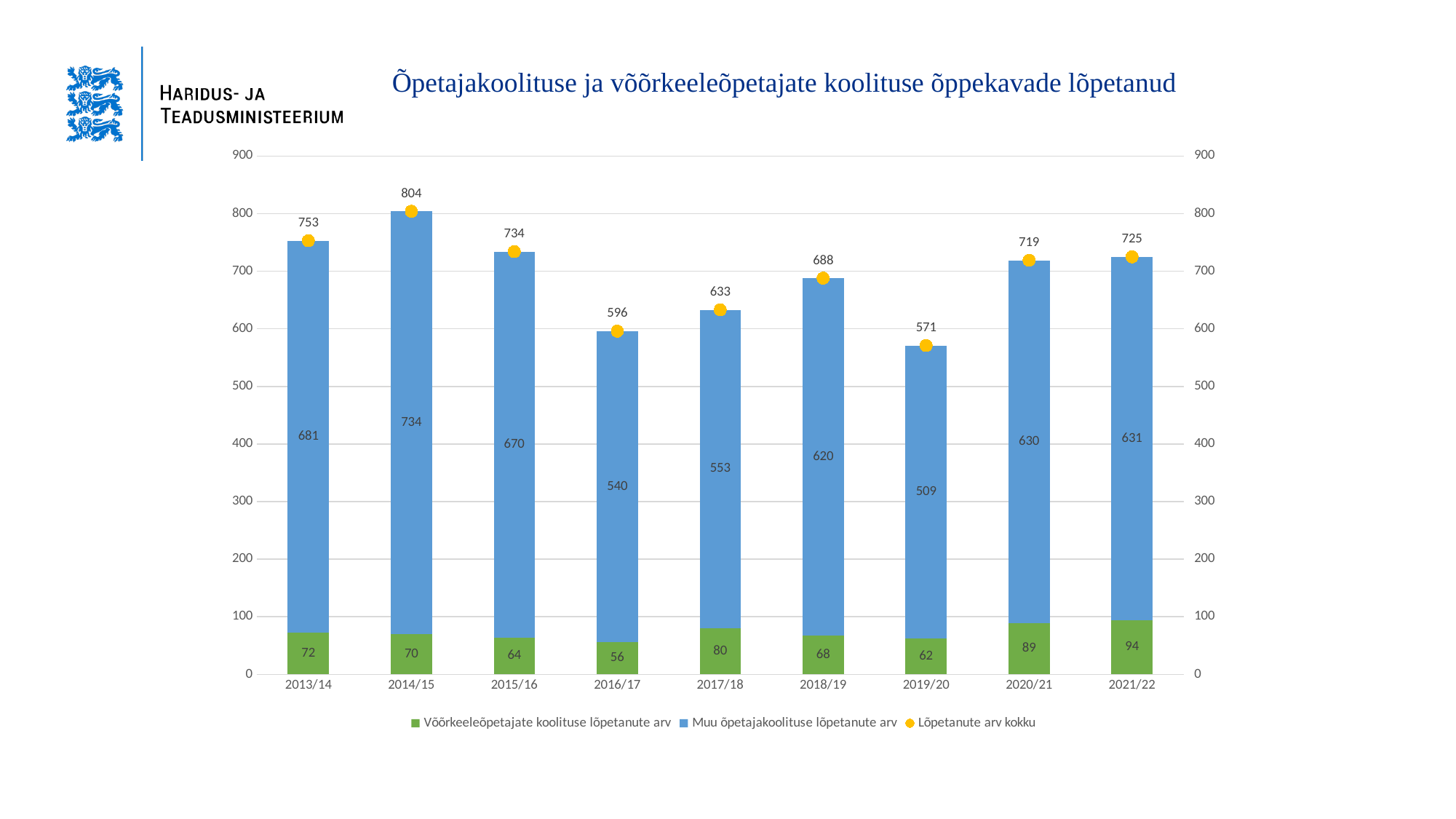
Is the total for 2019/20 greater or less than 600? less What is the Lõpetanute arv kokku value for 2018/19? 688 Which year has the lowest Võõrkeeleõpetajate koolituse lõpetanute arv? 2016/17 What is the total of the stacked bar for 2020/21? 719 What kind of chart is shown on the slide? Stacked bar chart with total markers Which year has the highest Lõpetanute arv kokku? 2014/15 How many academic years are shown on the x axis? 9 What is the value of Võõrkeeleõpetajate koolituse lõpetanute arv for 2021/22? 94 What is the value of Muu õpetajakoolituse lõpetanute arv for 2016/17? 540 Which is larger: Muu õpetajakoolituse lõpetanute arv in 2017/18 or in 2018/19? 2018/19 How many series does the legend list? 3 What is the difference between the Lõpetanute arv kokku values for 2014/15 and 2019/20? 233